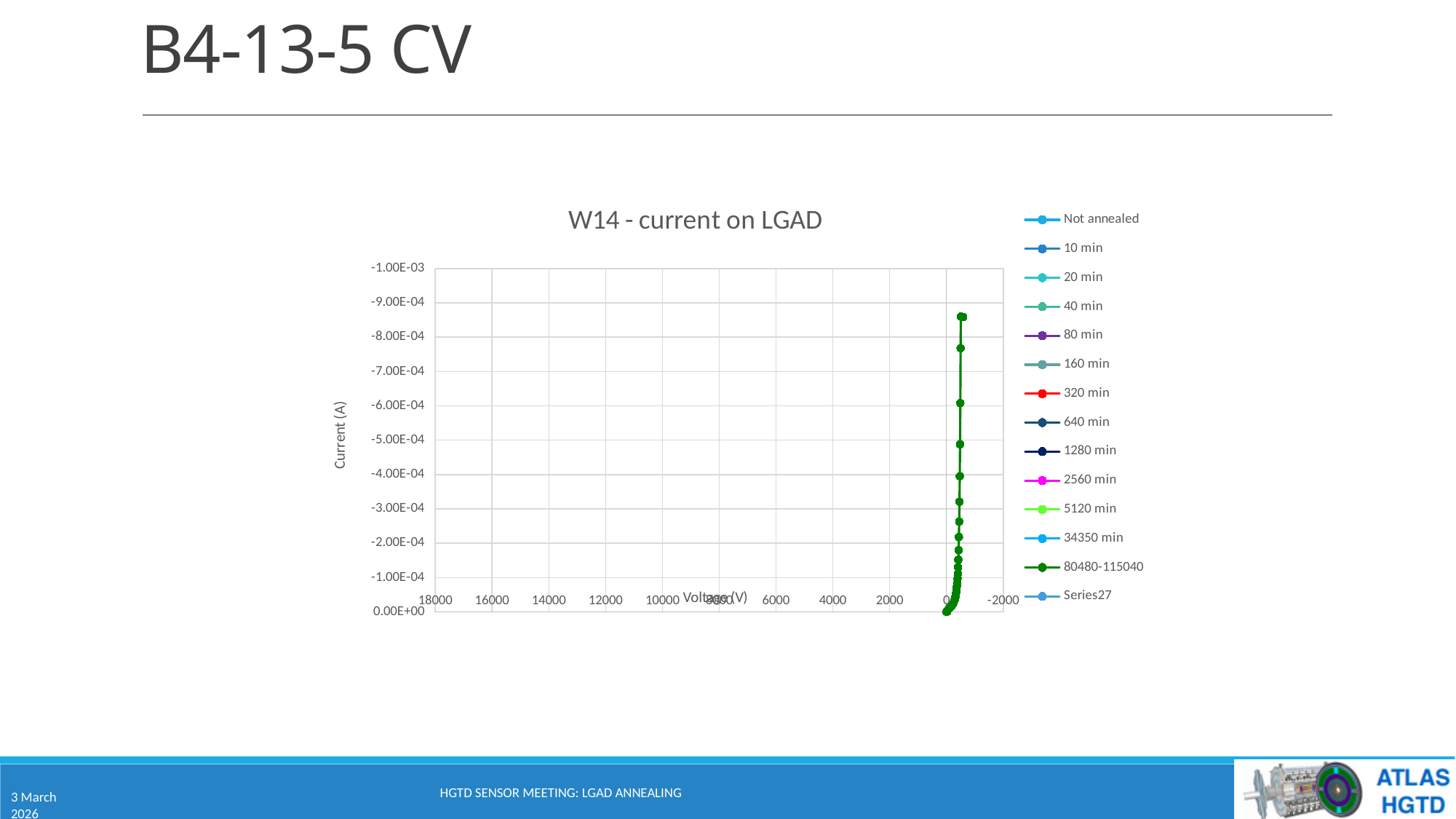
What is the title of the chart? W14 - current on LGAD Does the plotted curve extend beyond the -8.00E-04 gridline on the vertical axis? Yes Which legend entry corresponds to the dark green series that is visibly plotted on the chart? 80480-115040 What kind of chart is shown on the slide? Line chart Near which x-axis tick value do all the plotted points cluster? 0 What is the last entry listed in the chart legend? Series27 Does the plotted curve reach the -9.00E-04 gridline on the vertical axis? No What is the largest voltage value shown on the horizontal axis? 18000 How many series does the legend of the chart list? 14 What is the label of the vertical axis of the chart? Current (A)